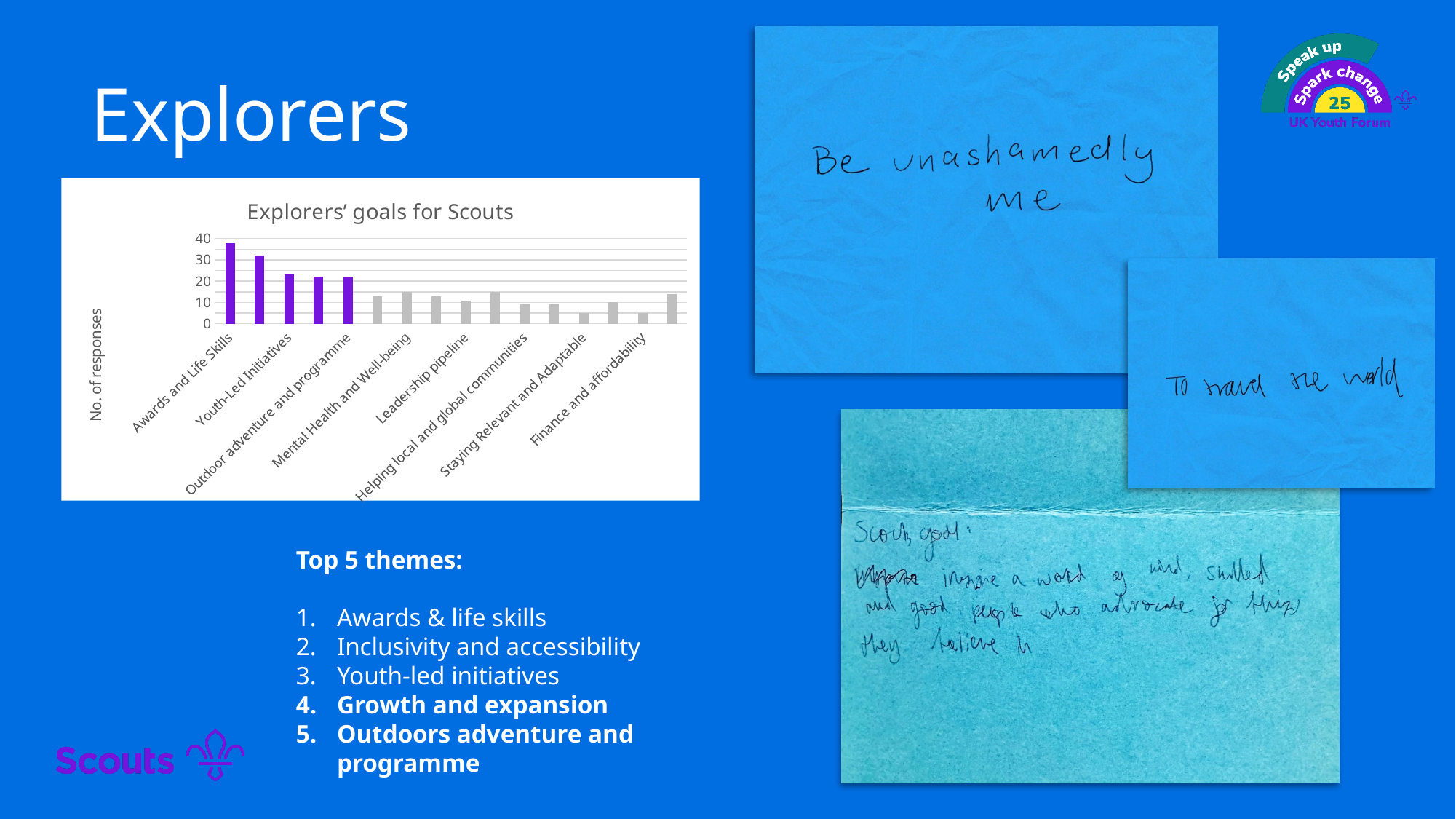
What kind of chart is shown on the slide? bar chart Which category has the highest number of responses? Awards and Life Skills Is the value for Staying Relevant and Adaptable greater or less than 10? less Is the value for Youth-Led Initiatives greater or less than 30? less Do the values generally rise or fall from left to right across the chart? fall Is the value for Mental Health and Well-being greater or less than 10? greater Which has more responses, Mental Health and Well-being or Finance and affordability? Mental Health and Well-being What is the label on the vertical axis of the chart? No. of responses What is the title of the chart? Explorers' goals for Scouts Which has more responses, Awards and Life Skills or Youth-Led Initiatives? Awards and Life Skills